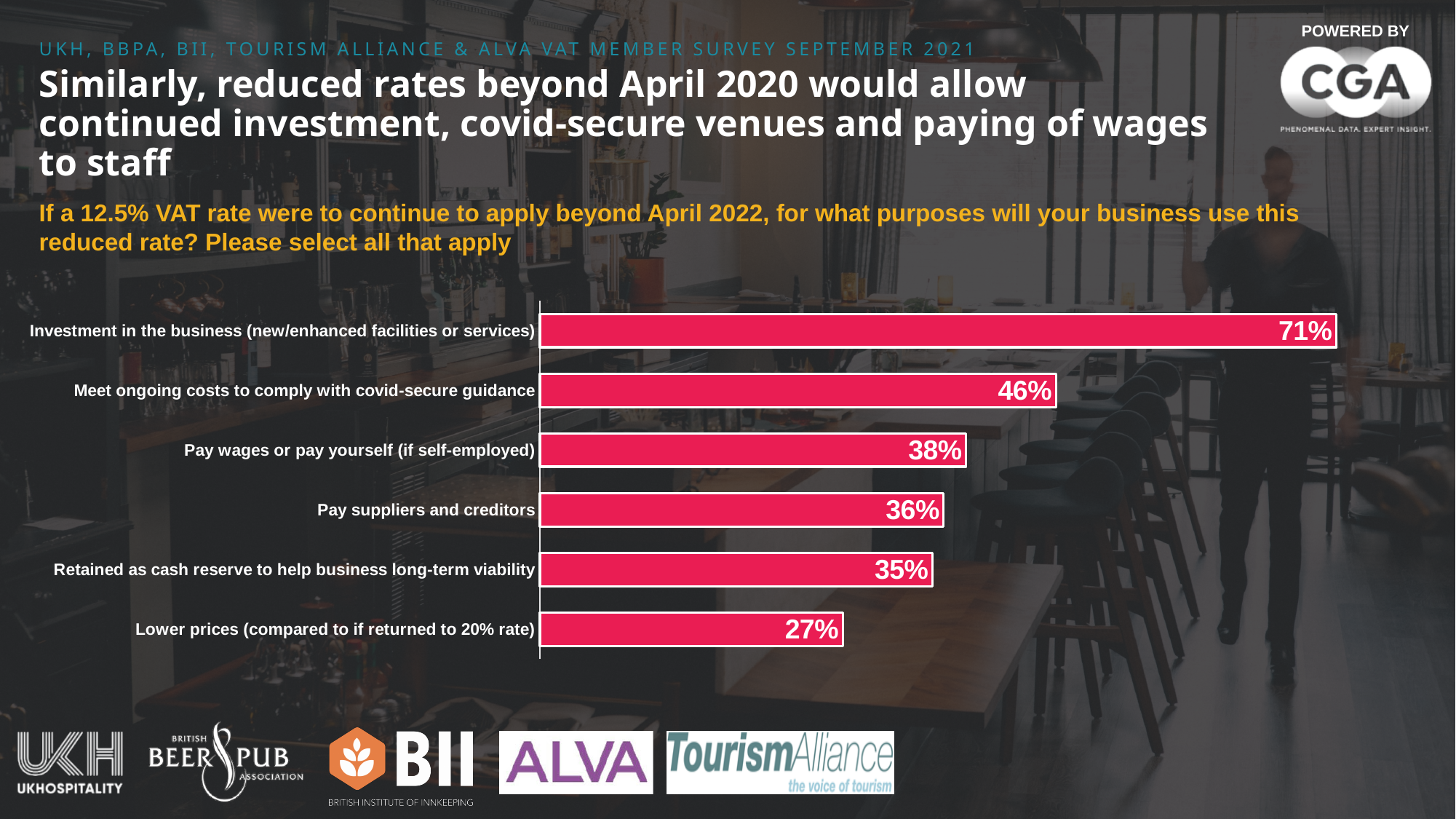
What percentage of respondents selected 'Investment in the business (new/enhanced facilities or services)'? 71% How many purposes (categories) are shown in the chart? 6 Which purpose has the lowest percentage? Lower prices (compared to if returned to 20% rate) What is the value for 'Lower prices (compared to if returned to 20% rate)'? 27% What is the difference in percentage points between 'Investment in the business' and 'Meet ongoing costs to comply with covid-secure guidance'? 25 percentage points What colour are the bars in the chart? Red/pink Which is larger: 'Pay wages or pay yourself (if self-employed)' or 'Lower prices (compared to if returned to 20% rate)'? Pay wages or pay yourself (if self-employed) What percentage is shown for 'Pay wages or pay yourself (if self-employed)'? 38% What is the value for 'Meet ongoing costs to comply with covid-secure guidance'? 46% What type of chart is shown on the slide? Bar chart What is the difference between 'Pay suppliers and creditors' and 'Retained as cash reserve to help business long-term viability'? 1 percentage point Which purpose has the highest percentage? Investment in the business (new/enhanced facilities or services)